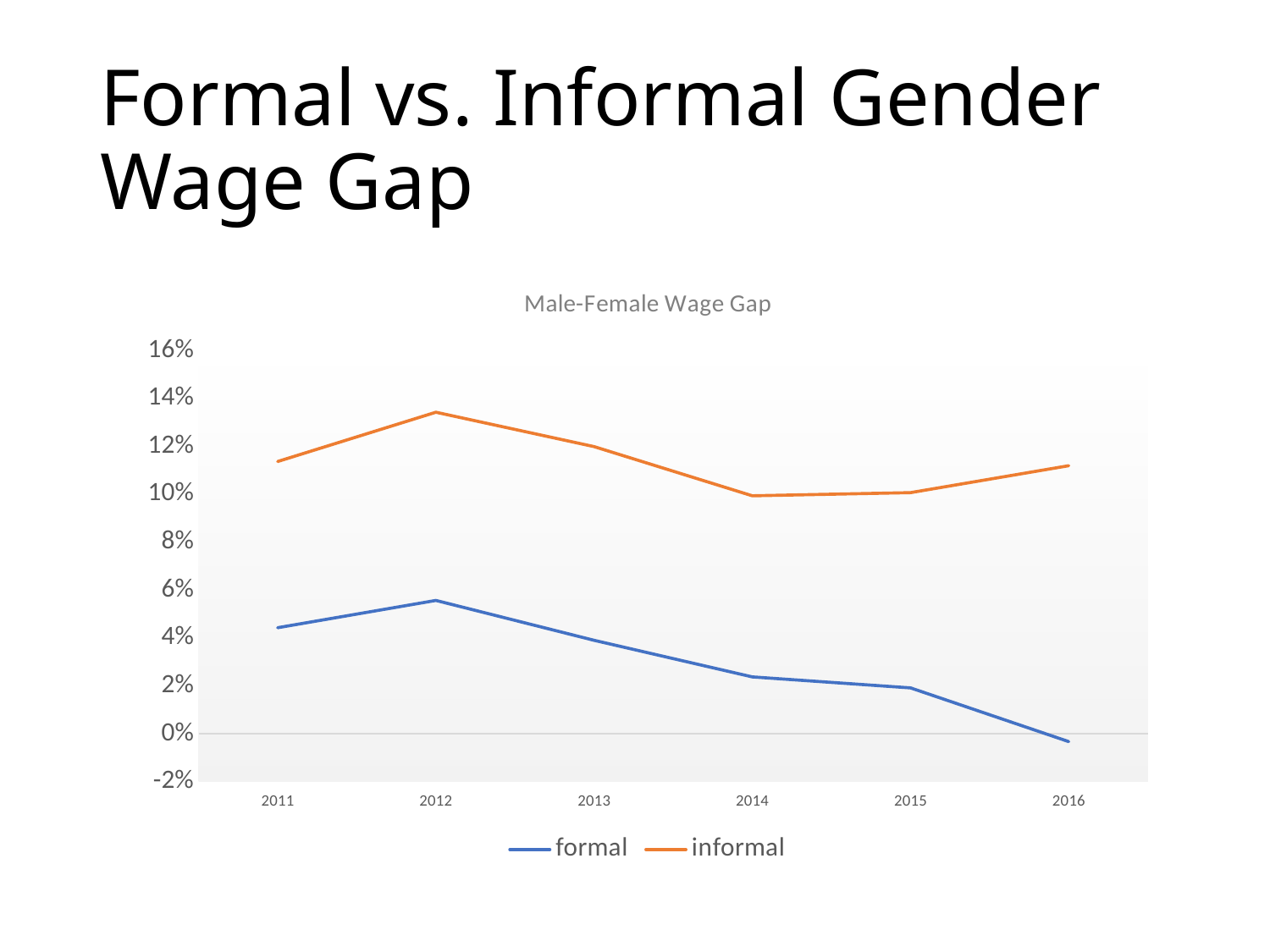
In which year does the informal series reach its highest value? 2012 What kind of chart is shown on the slide? line chart Does the formal series rise or fall from 2012 to 2016? fall Which series has the larger value in 2011, formal or informal? informal In which year does the formal series reach its lowest value? 2016 Is the value for formal in 2012 greater or less than 4%? greater In which year does the formal series reach its highest value? 2012 How many years are plotted along the x axis? 6 Is the value for formal in 2014 greater or less than 4%? less What is the title of the chart? Male-Female Wage Gap Is the value for informal in 2012 greater or less than 12%? greater How many series does the legend list? 2